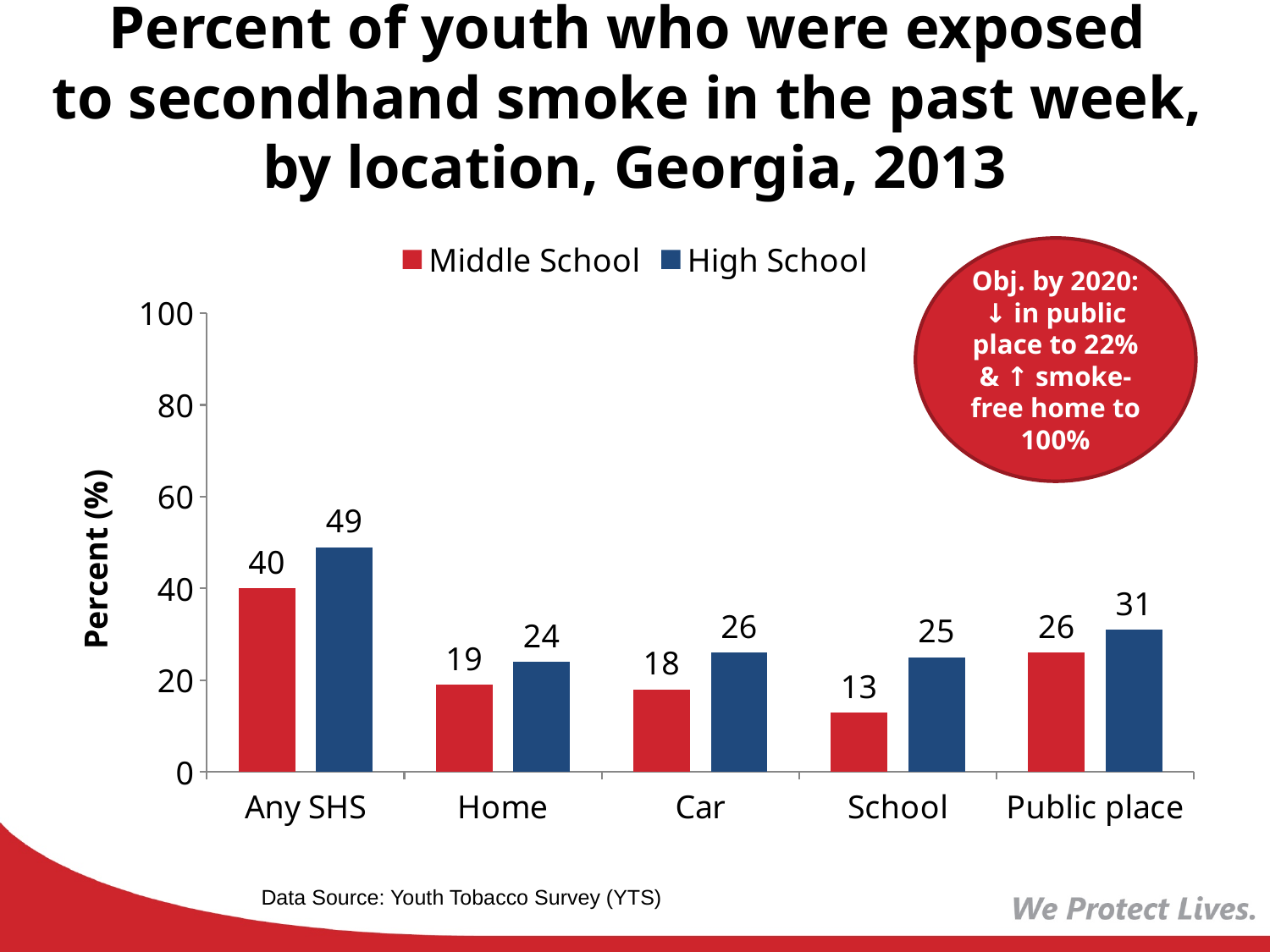
How many series does the legend list? 2 Which location has the highest High School value? Any SHS What kind of chart is shown on the slide? bar chart What is the difference between the High School and Middle School values for Any SHS? 9 What is the Middle School value for School? 13 Which location has the lowest Middle School value? School What is the High School value for Public place? 31 Which is larger, the Middle School value for Public place or the Middle School value for Car? Public place What is the label of the y axis? Percent (%) What is the Middle School value for Any SHS? 40 Is the High School value for Home greater or less than 20? greater How many locations are shown on the x axis? 5